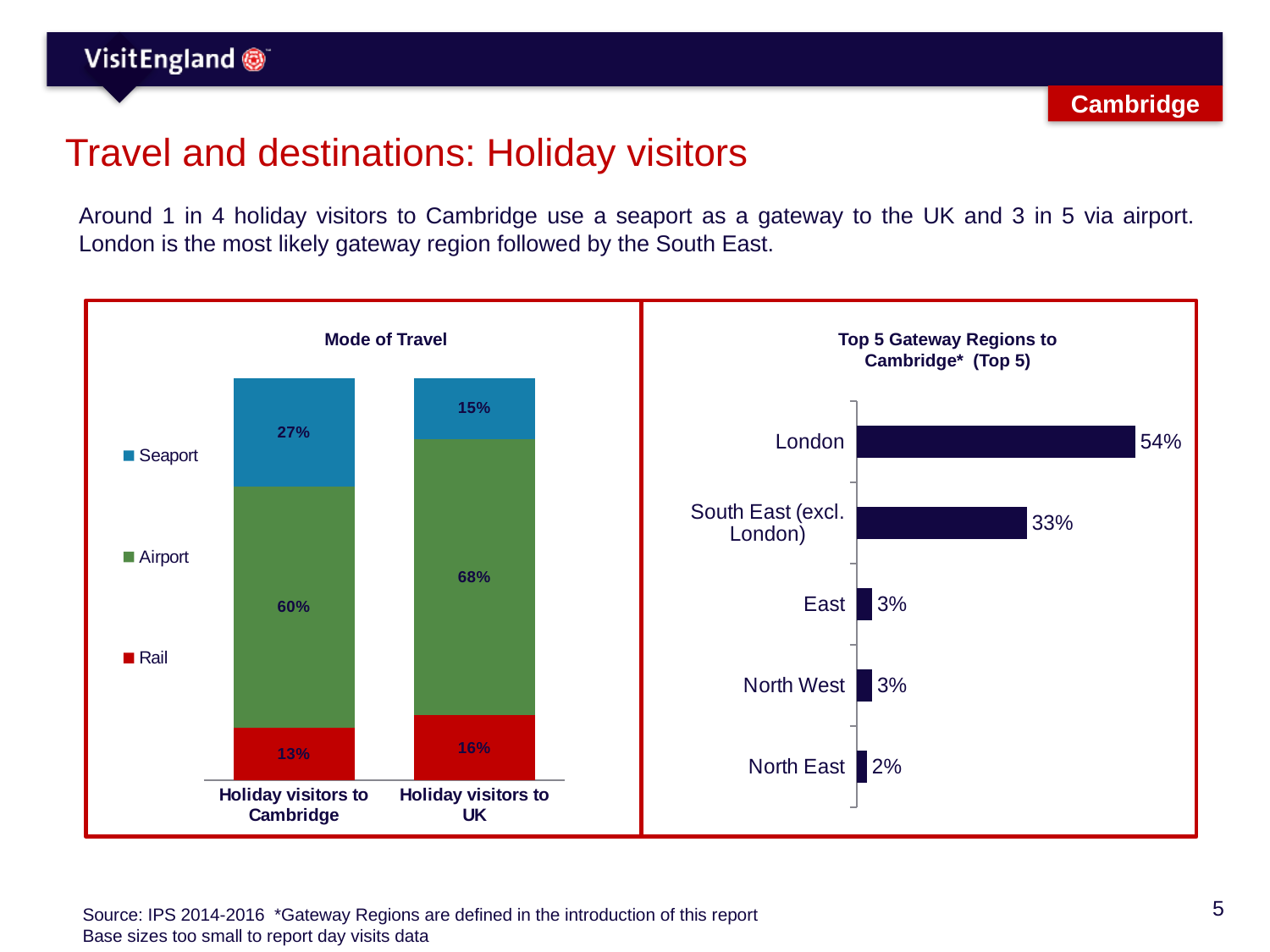
In the 'Top 5 Gateway Regions to Cambridge' chart, what is the difference between London and South East (excl. London)? 21% In the 'Top 5 Gateway Regions to Cambridge' chart, what is the value for London? 54% In the 'Top 5 Gateway Regions to Cambridge' chart, how many regions are shown? 5 In the 'Mode of Travel' chart, what is the rail share for holiday visitors to Cambridge? 13% In the 'Top 5 Gateway Regions to Cambridge' chart, which region has the lowest value? North East In the 'Mode of Travel' chart, what is the total of the stacked bar for holiday visitors to Cambridge? 100% In the 'Mode of Travel' chart, what is the difference between the seaport share for holiday visitors to Cambridge and for holiday visitors to the UK? 12% What kind of chart is the 'Top 5 Gateway Regions to Cambridge' chart? Bar chart In the 'Mode of Travel' chart, how many series does the legend list? 3 In the 'Mode of Travel' chart, which is larger: the rail share for holiday visitors to Cambridge or for holiday visitors to the UK? Holiday visitors to UK In the 'Mode of Travel' chart, what percentage of holiday visitors to Cambridge travel by seaport? 27% In the 'Mode of Travel' chart, what percentage of holiday visitors to the UK travel by airport? 68%